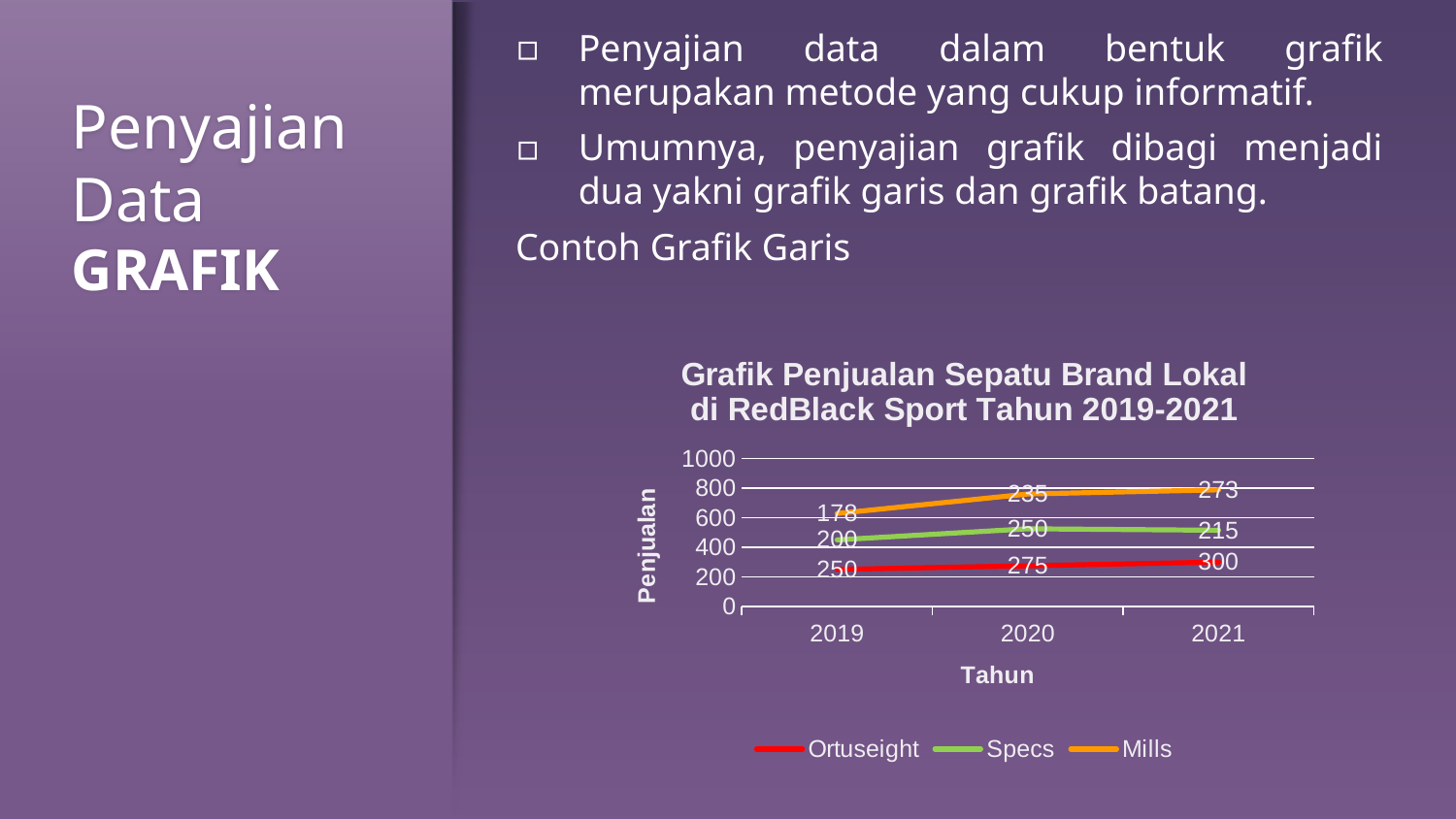
What is the value for Specs in 2020? 250 Do the Ortuseight values rise or fall from 2019 to 2021? rise How many years are shown on the x axis? 3 What type of chart is shown on the slide? line chart What is the title of the chart? Grafik Penjualan Sepatu Brand Lokal di RedBlack Sport Tahun 2019-2021 In which year is the Mills value lowest? 2019 Which is larger in 2021, the Specs value or the Mills value? Mills What is the difference between the Ortuseight values in 2021 and 2019? 50 What is the value for Mills in 2019? 178 In which year is the Ortuseight value highest? 2021 What is the value for Ortuseight in 2021? 300 How many series does the legend list? 3